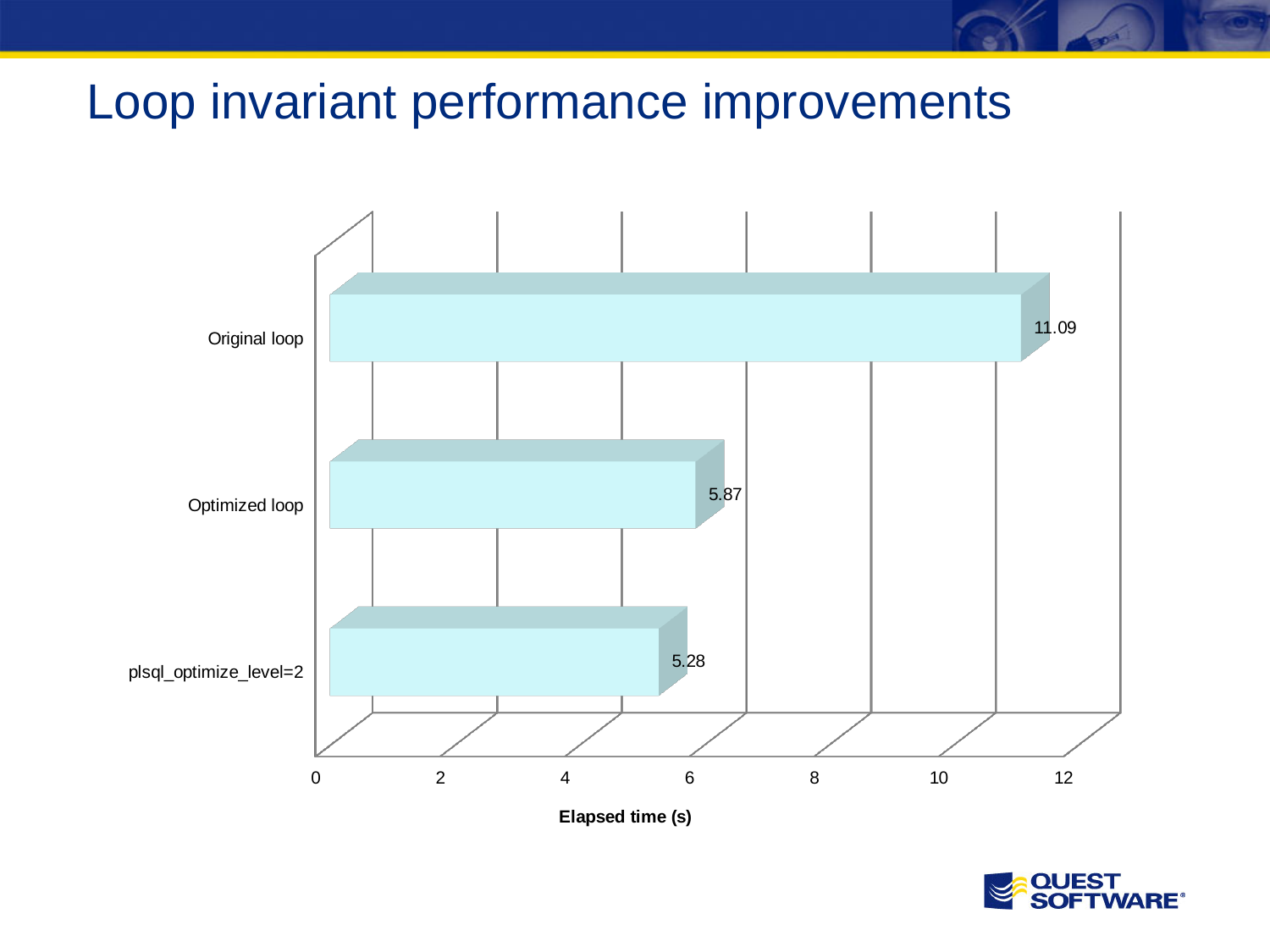
What is the difference in elapsed time between the Original loop and the Optimized loop? 5.22 What kind of chart is shown on the slide? Bar chart Which category has the lowest elapsed time? plsql_optimize_level=2 How many categories are shown in the chart? 3 What is the label of the horizontal axis? Elapsed time (s) What is the elapsed time for the Optimized loop? 5.87 What is the difference in elapsed time between the Optimized loop and plsql_optimize_level=2? 0.59 Is the elapsed time for the Original loop greater or less than 10? greater What is the elapsed time for plsql_optimize_level=2? 5.28 Which has a larger elapsed time, the Optimized loop or plsql_optimize_level=2? Optimized loop What is the elapsed time for the Original loop? 11.09 Which category has the highest elapsed time? Original loop